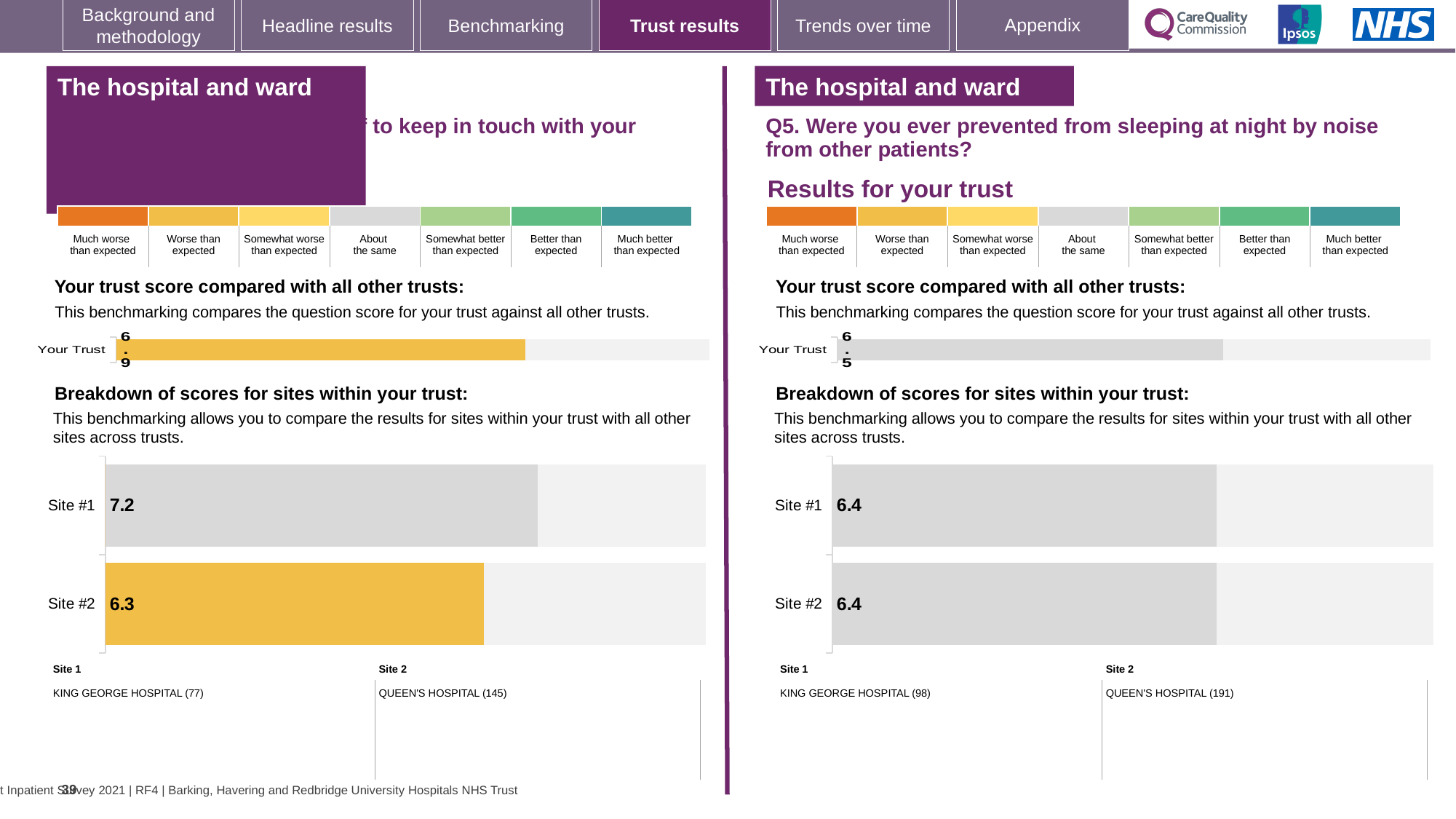
On the left-hand site breakdown chart, which site has the lower score? Site #2 How many sites are shown on the Q5 site breakdown chart? 2 On the Q5 site breakdown chart, what is the difference between the Site #1 and Site #2 scores? 0 On the left-hand site breakdown chart, what is the score for Site #1? 7.2 On the left-hand site breakdown chart, which site has the higher score? Site #1 What type of chart is used for the site breakdown on the left-hand side of the slide? Bar chart On the left-hand site breakdown chart, what is the difference between the Site #1 and Site #2 scores? 0.9 On the Q5 (prevented from sleeping at night by noise) site breakdown chart, what is the score for Site #1? 6.4 On the left-hand site breakdown chart, what is the score for Site #2? 6.3 On the Q5 (prevented from sleeping at night by noise) site breakdown chart, what is the score for Site #2? 6.4 On the left-hand 'Your trust score compared with all other trusts' chart, what is the score shown for Your Trust? 6.9 On the Q5 'Your trust score compared with all other trusts' chart, what is the score shown for Your Trust? 6.5